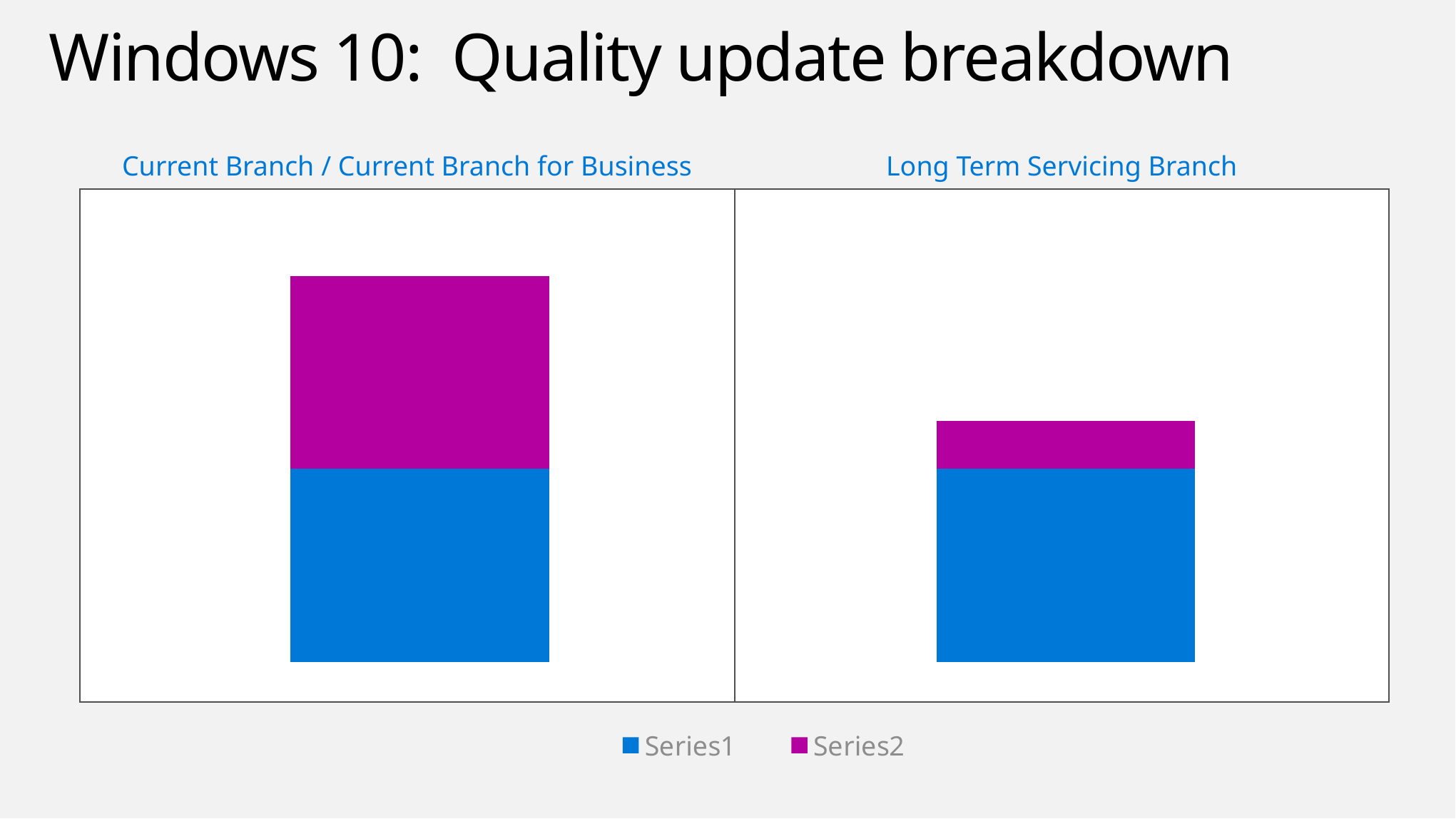
How many series does the legend list? 2 Which category has the shortest stacked bar overall? Long Term Servicing Branch Which category has the larger Series2 segment, Current Branch / Current Branch for Business or Long Term Servicing Branch? Current Branch / Current Branch for Business Within the Long Term Servicing Branch bar, which series has the larger segment, Series1 or Series2? Series1 What colour represents Series2 in the chart? magenta What are the names of the two series in the legend? Series1 and Series2 Which category has the tallest stacked bar overall? Current Branch / Current Branch for Business Is the total stacked bar for Current Branch / Current Branch for Business larger or smaller than the total for Long Term Servicing Branch? larger What kind of chart is shown on the slide? stacked bar chart How many categories (bars) does the chart show? 2